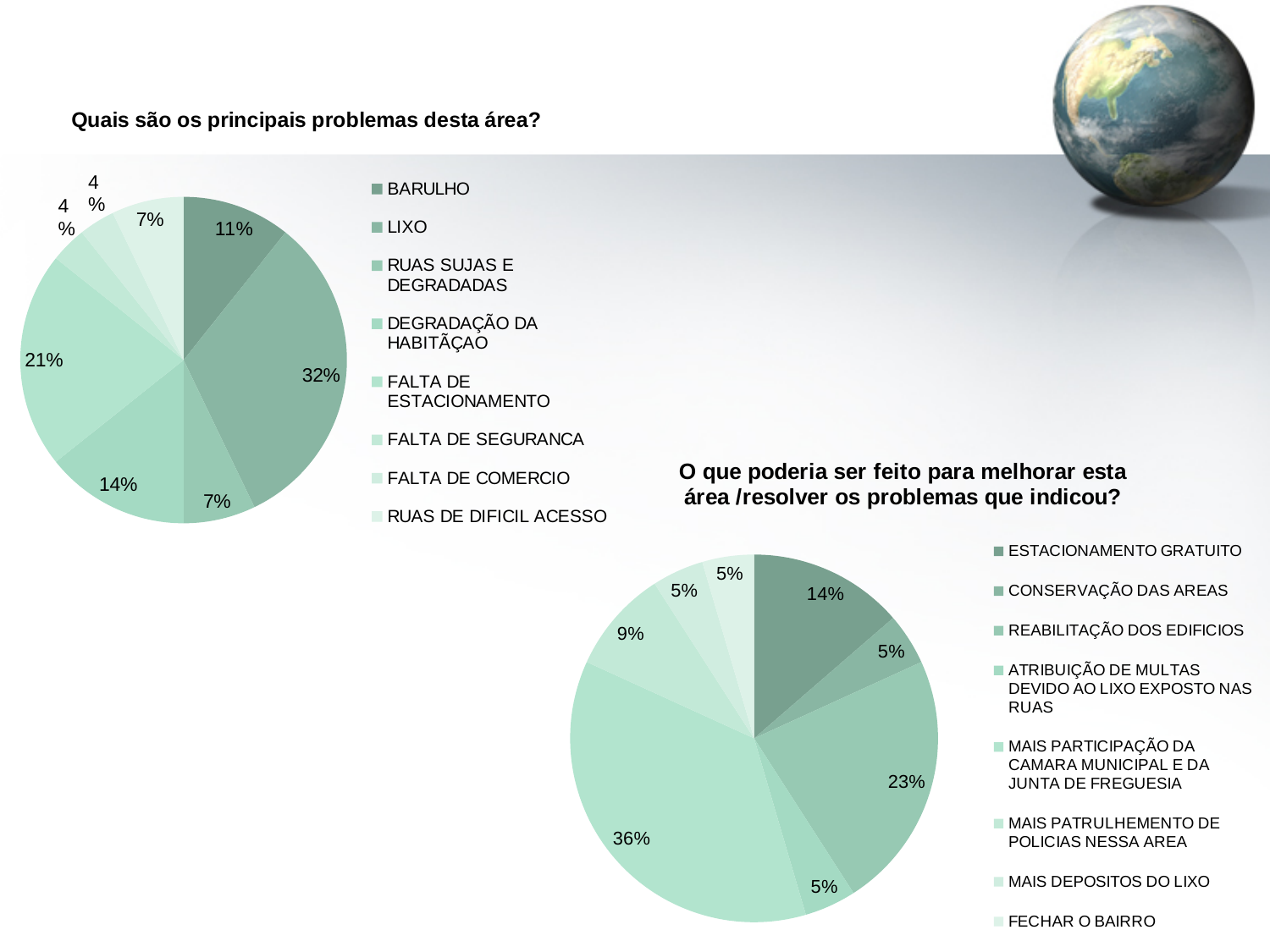
In the chart titled 'Quais são os principais problemas desta área?', how many categories does the legend list? 8 In the chart titled 'Quais são os principais problemas desta área?', which category has the largest slice? LIXO In the chart titled 'Quais são os principais problemas desta área?', what is the difference between the LIXO slice and the BARULHO slice? 21% In the chart titled 'Quais são os principais problemas desta área?', what percentage is shown for LIXO? 32% In the chart titled 'O que poderia ser feito para melhorar esta área /resolver os problemas que indicou?', what percentage is shown for MAIS PARTICIPAÇÃO DA CAMARA MUNICIPAL E DA JUNTA DE FREGUESIA? 36% In the chart titled 'O que poderia ser feito para melhorar esta área /resolver os problemas que indicou?', what is the difference between the ESTACIONAMENTO GRATUITO slice and the MAIS PATRULHEMENTO DE POLICIAS NESSA AREA slice? 5% In the chart titled 'Quais são os principais problemas desta área?', what percentage is shown for FALTA DE ESTACIONAMENTO? 21% In the chart titled 'O que poderia ser feito para melhorar esta área /resolver os problemas que indicou?', how many categories does the legend list? 8 In the chart titled 'O que poderia ser feito para melhorar esta área /resolver os problemas que indicou?', which category has the largest slice? MAIS PARTICIPAÇÃO DA CAMARA MUNICIPAL E DA JUNTA DE FREGUESIA In the chart titled 'Quais são os principais problemas desta área?', which is larger: DEGRADAÇÃO DA HABITAÇÃO or BARULHO? DEGRADAÇÃO DA HABITAÇÃO What kind of chart is used for 'O que poderia ser feito para melhorar esta área /resolver os problemas que indicou?'? Pie chart In the chart titled 'O que poderia ser feito para melhorar esta área /resolver os problemas que indicou?', what percentage is shown for REABILITAÇÃO DOS EDIFICIOS? 23%